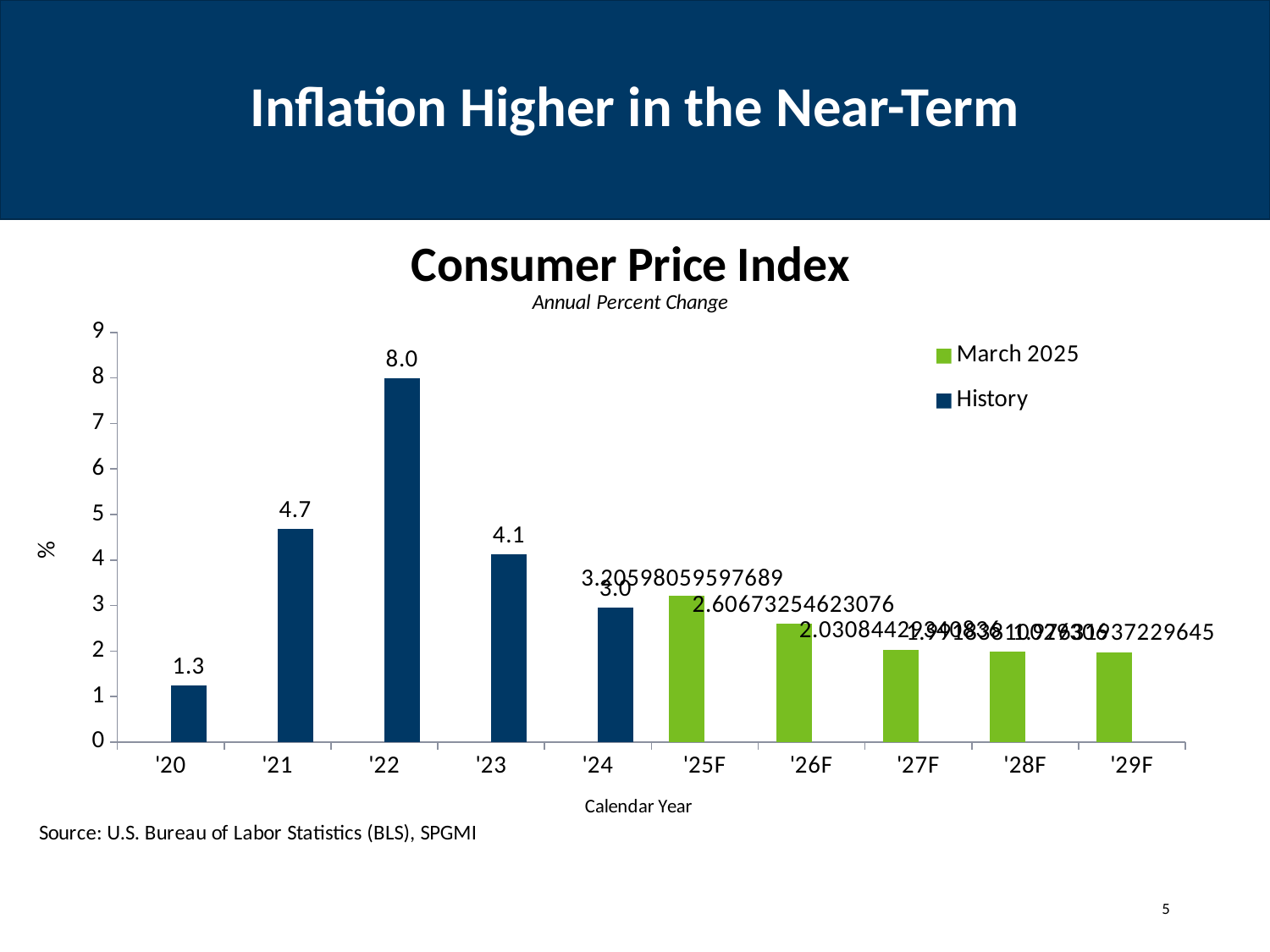
What is the difference between the values for '22 and '21 in the Consumer Price Index chart? 3.3 What kind of chart is the Consumer Price Index chart? bar chart What is the value for '20 in the Consumer Price Index chart? 1.3 How many years are shown on the x axis of the Consumer Price Index chart? 10 How many series does the legend of the Consumer Price Index chart list? 2 Which year has the highest value in the Consumer Price Index chart? '22 Is the value for '26F in the Consumer Price Index chart greater or less than 3? less Which year has the lowest value in the Consumer Price Index chart? '20 Do the forecast values from '25F to '29F rise or fall in the Consumer Price Index chart? fall What is the value for '23 in the Consumer Price Index chart? 4.1 Which is larger in the Consumer Price Index chart, the value for '21 or the value for '23? '21 What is the value for '22 in the Consumer Price Index chart? 8.0